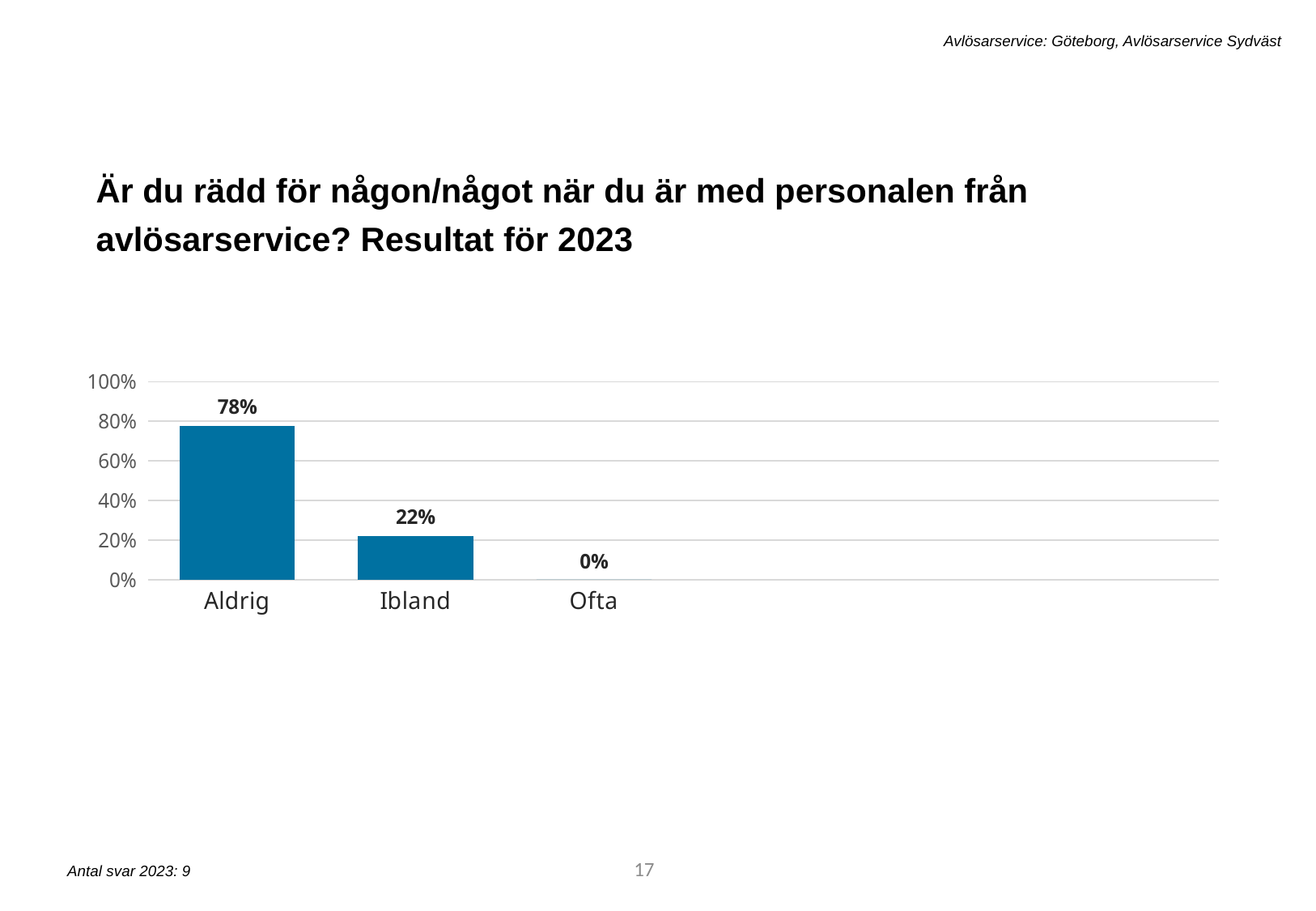
Which category has the highest value? Aldrig What is the value for Ibland? 22% Do the values rise or fall from Aldrig to Ofta along the x axis? fall How many categories are shown on the x axis? 3 What is the number of responses (Antal svar) for 2023 stated on the slide? 9 What is the value for Ofta? 0% What is the value for Aldrig? 78% Which is larger, the value for Ibland or the value for Ofta? Ibland Which category has the lowest value? Ofta What kind of chart is shown on the slide? bar chart What is the difference between the values for Aldrig and Ibland? 56% Is the value for Aldrig greater or less than 60%? greater